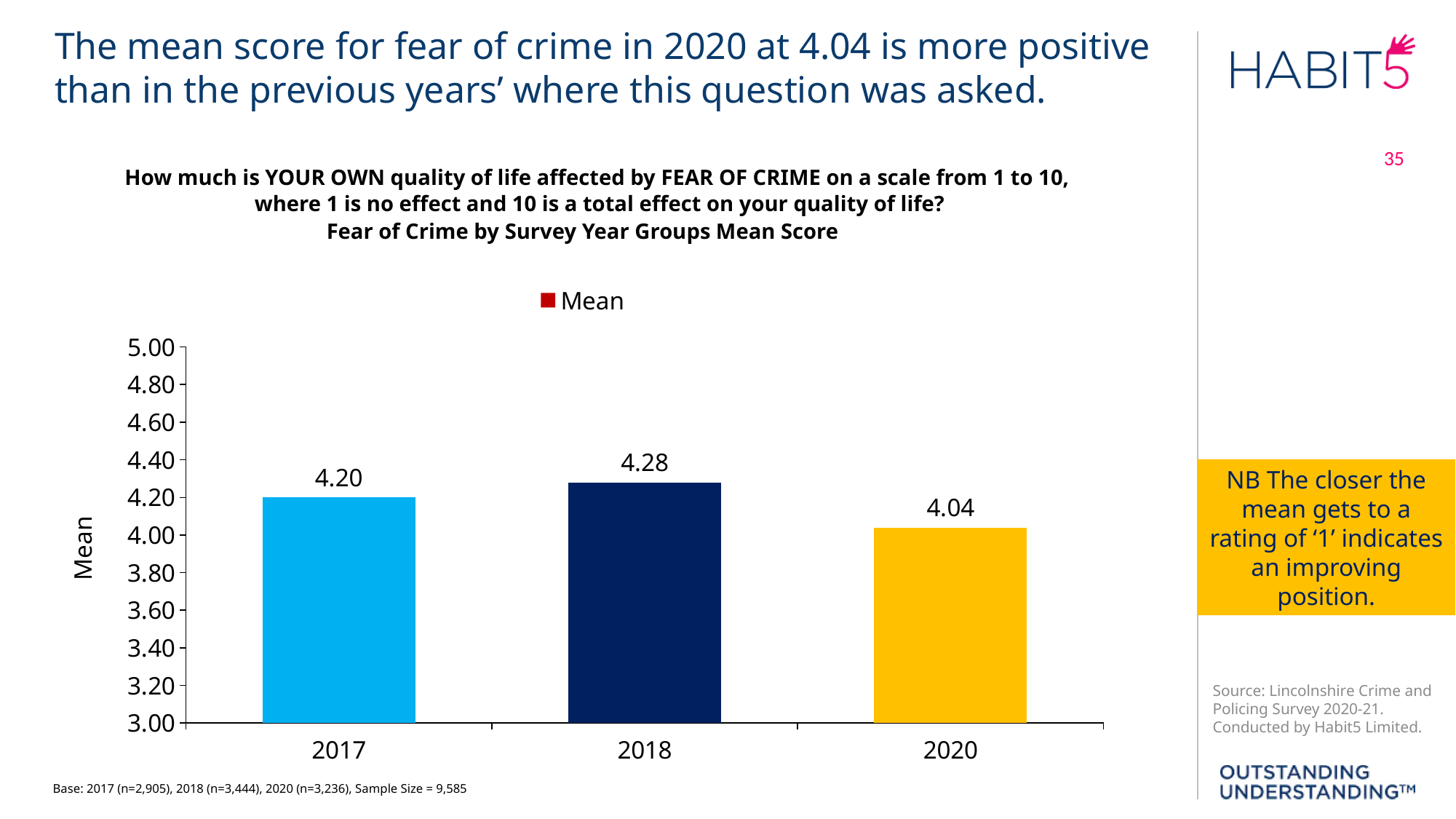
Is the mean score for 2020 greater or less than 4.20? less Which survey year has the lowest mean score? 2020 What is the difference between the mean scores for 2018 and 2017? 0.08 What is the mean fear of crime score for 2017? 4.20 What is the difference between the mean scores for 2018 and 2020? 0.24 Which is larger, the mean score for 2017 or for 2020? 2017 What kind of chart is shown on the slide? bar chart Which survey year has the highest mean score? 2018 What is the mean fear of crime score for 2018? 4.28 What is the only series listed in the chart legend? Mean What is the mean fear of crime score for 2020? 4.04 How many survey years are shown on the chart? 3